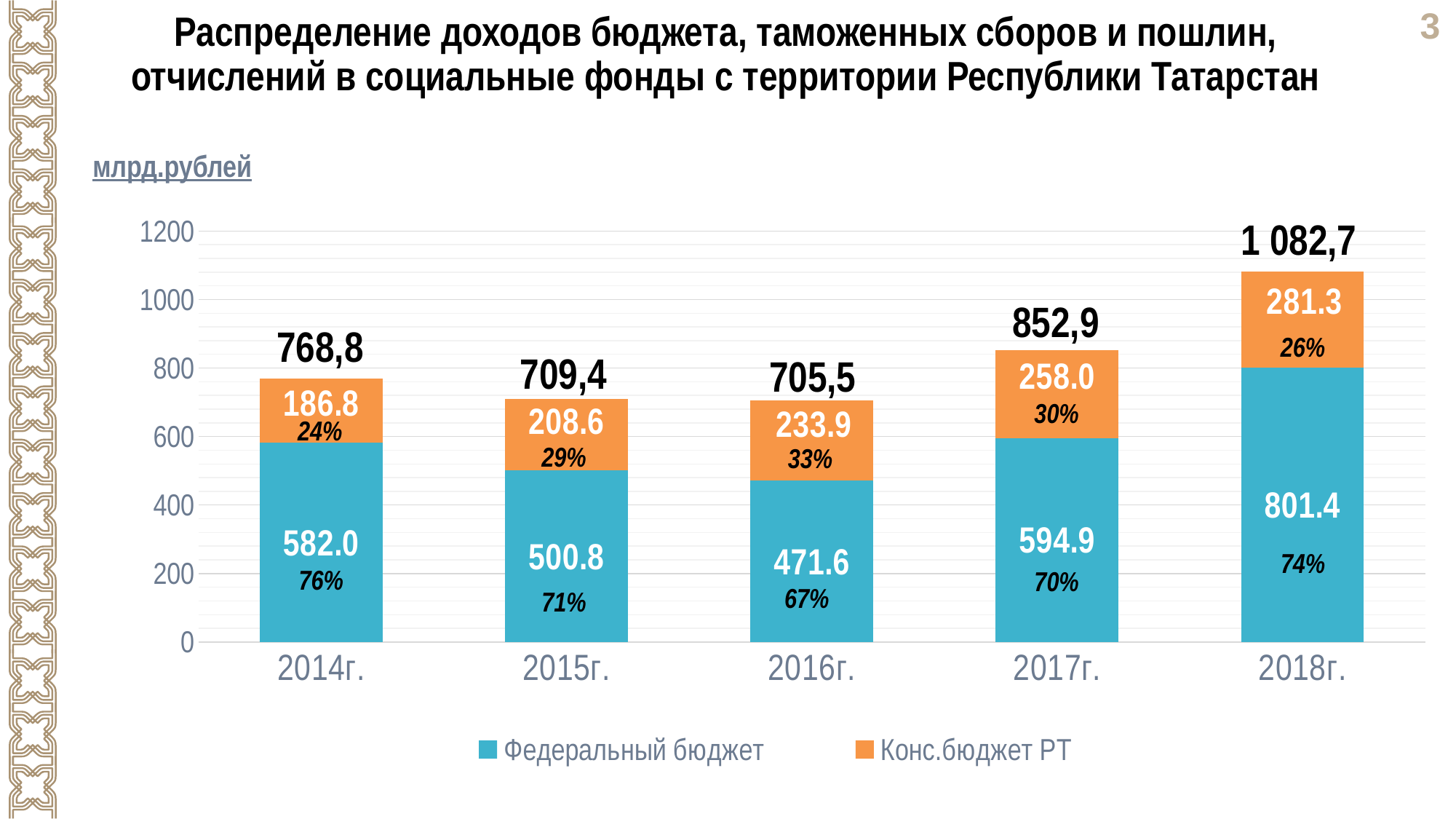
Which year has the highest value for Федеральный бюджет? 2018г. What is the difference between the Конс.бюджет РТ values for 2018г. and 2017г.? 23.3 What is the value for Конс.бюджет РТ in 2018г.? 281.3 What is the total of the stacked bar for 2017г.? 852,9 What kind of chart is shown on the slide? Stacked bar chart How many series does the legend list? 2 How many years are shown on the x axis? 5 Which year has the lowest value for Конс.бюджет РТ? 2014г. Which is larger: the Федеральный бюджет value in 2015г. or in 2016г.? 2015г. What unit is indicated above the chart? млрд.рублей What percentage share does Конс.бюджет РТ have in 2016г.? 33% What is the value for Федеральный бюджет in 2014г.? 582.0